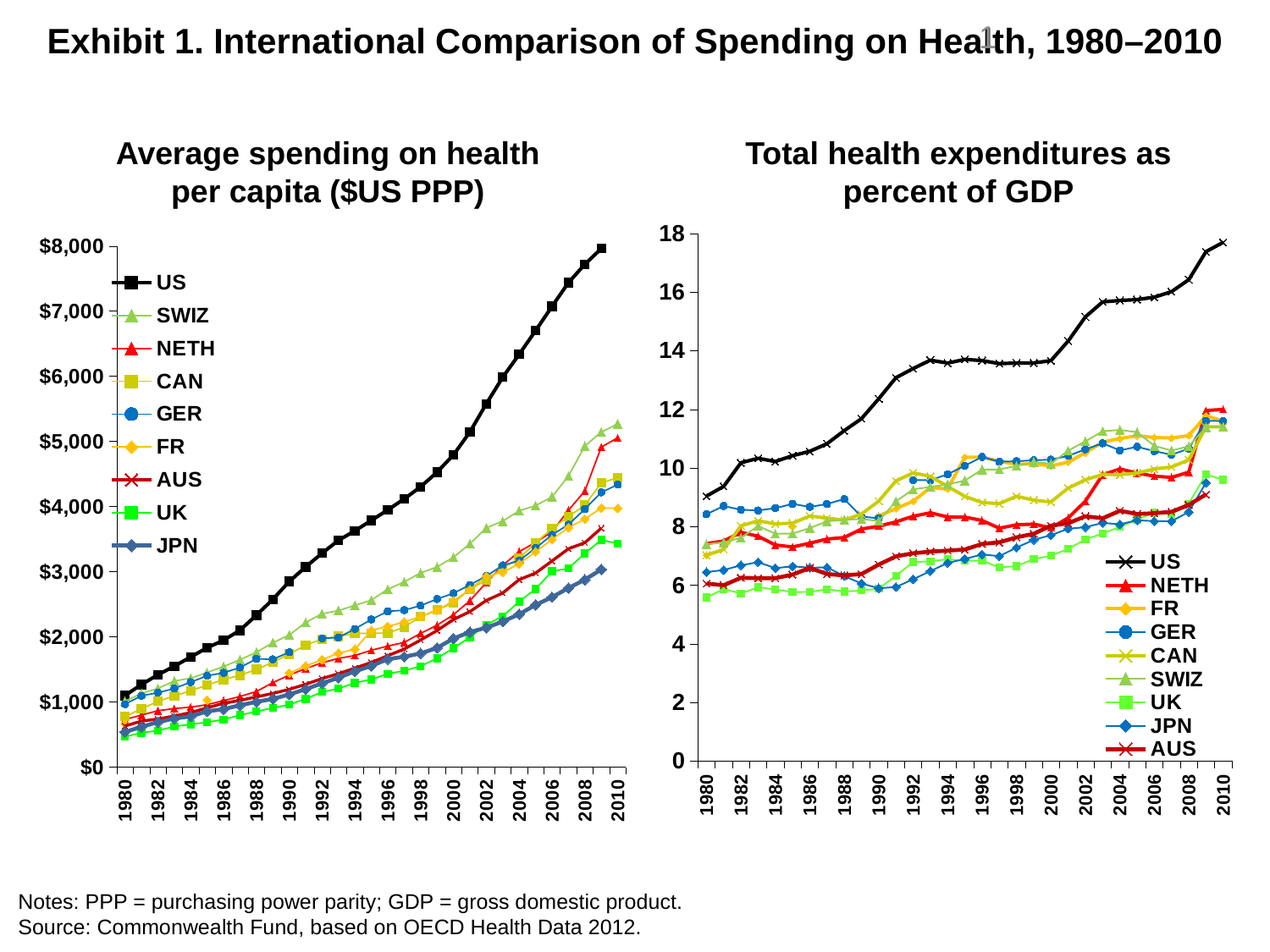
What kind of chart is the right chart, 'Total health expenditures as percent of GDP'? Line chart In the right chart, 'Total health expenditures as percent of GDP', how many series does the legend list? 9 In the right chart, 'Total health expenditures as percent of GDP', is the value for the US in 2000 greater or less than 12? greater In the left chart, 'Average spending on health per capita ($US PPP)', which country has the highest spending in 2010? US In the right chart, 'Total health expenditures as percent of GDP', is the value for the US in 2010 greater or less than 16? greater In the right chart, 'Total health expenditures as percent of GDP', is the value for the UK in 1980 greater or less than 6? less What kind of chart is the left chart, 'Average spending on health per capita ($US PPP)'? Line chart In the right chart, 'Total health expenditures as percent of GDP', which country has the highest value in 2010? US In the left chart, 'Average spending on health per capita ($US PPP)', how many series does the legend list? 9 In the left chart, 'Average spending on health per capita ($US PPP)', which series is drawn in black with square markers? US In the left chart, 'Average spending on health per capita ($US PPP)', does the US line rise or fall from 1980 to 2010? Rises